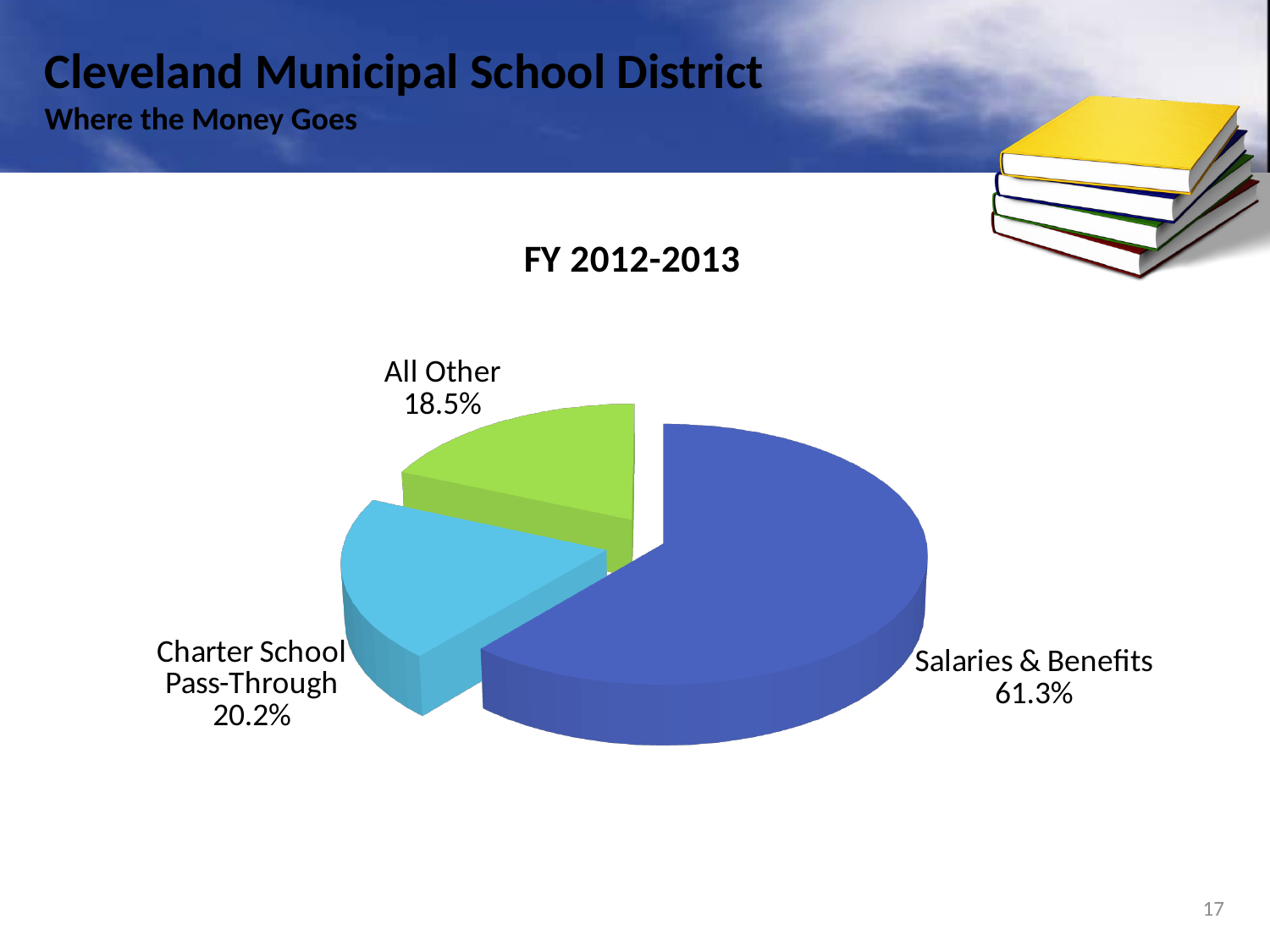
What share of the pie is Salaries & Benefits? 61.3% What kind of chart is shown on the slide? Pie chart Which slice of the pie is the smallest? All Other What is the title of the chart? FY 2012-2013 Which slice of the pie is the largest? Salaries & Benefits What colour is the Salaries & Benefits slice? Blue Which is larger, Charter School Pass-Through or All Other? Charter School Pass-Through What share of the pie is Charter School Pass-Through? 20.2% How many slices does the pie chart have? 3 What is the difference in percentage points between Charter School Pass-Through and All Other? 1.7 What is the difference in percentage points between Salaries & Benefits and Charter School Pass-Through? 41.1 What share of the pie is All Other? 18.5%